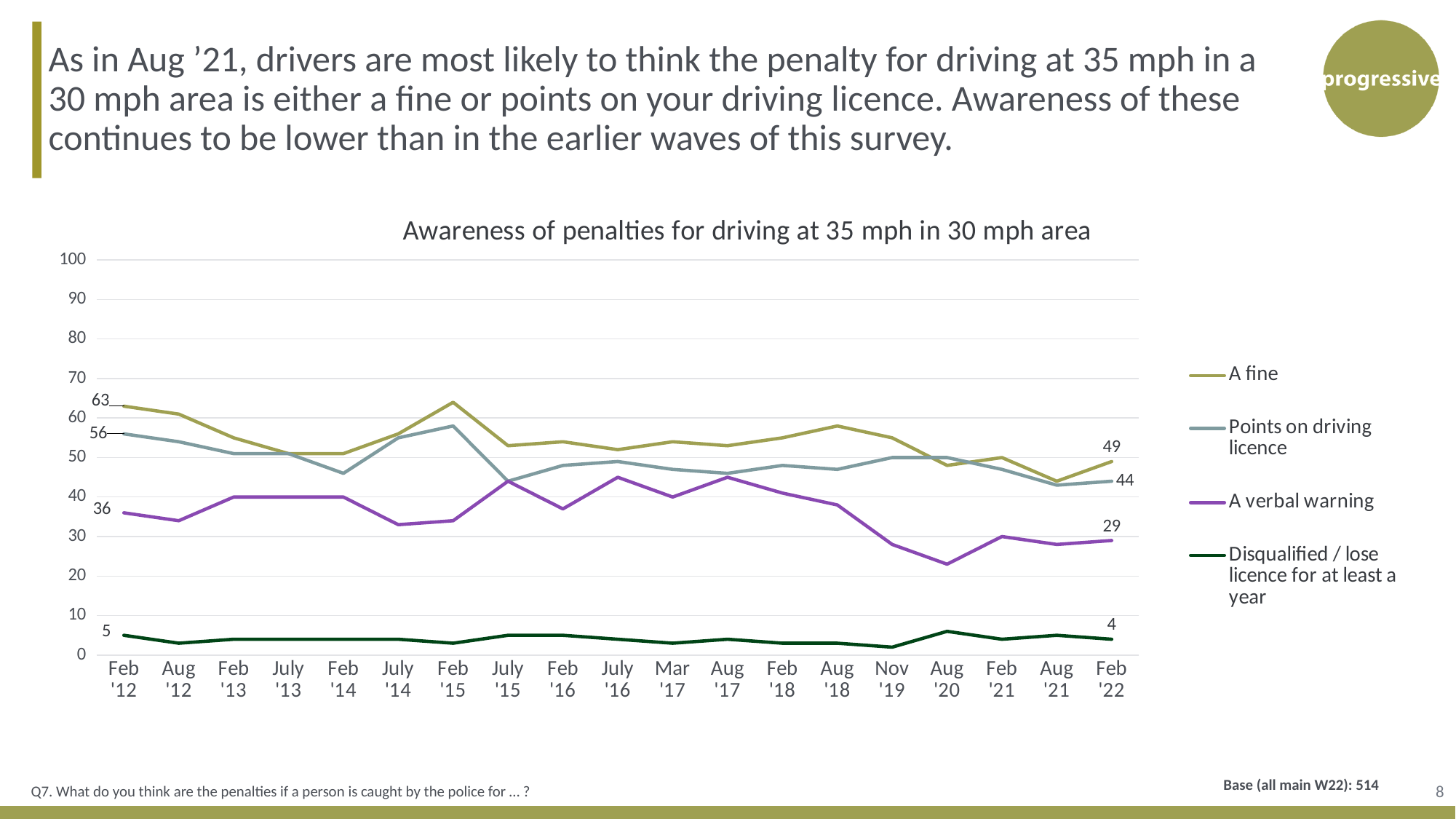
What is the difference between the 'A fine' values in Feb '12 and Feb '22? 14 What is the value for 'A verbal warning' in Feb '22? 29 What type of chart is shown on the slide? line chart What is the value for 'Disqualified / lose licence for at least a year' in Feb '12? 5 Which is larger in Feb '12: 'A fine' or 'Points on driving licence'? A fine Is the value for 'A verbal warning' in Aug '20 greater or less than 30? less What is the value for 'Points on driving licence' in Feb '22? 44 What is the title of the chart? Awareness of penalties for driving at 35 mph in 30 mph area Which series has the lowest value in Feb '22? Disqualified / lose licence for at least a year What is the value for 'A fine' in Feb '12? 63 How many time points are shown on the x axis? 19 How many series does the legend list? 4